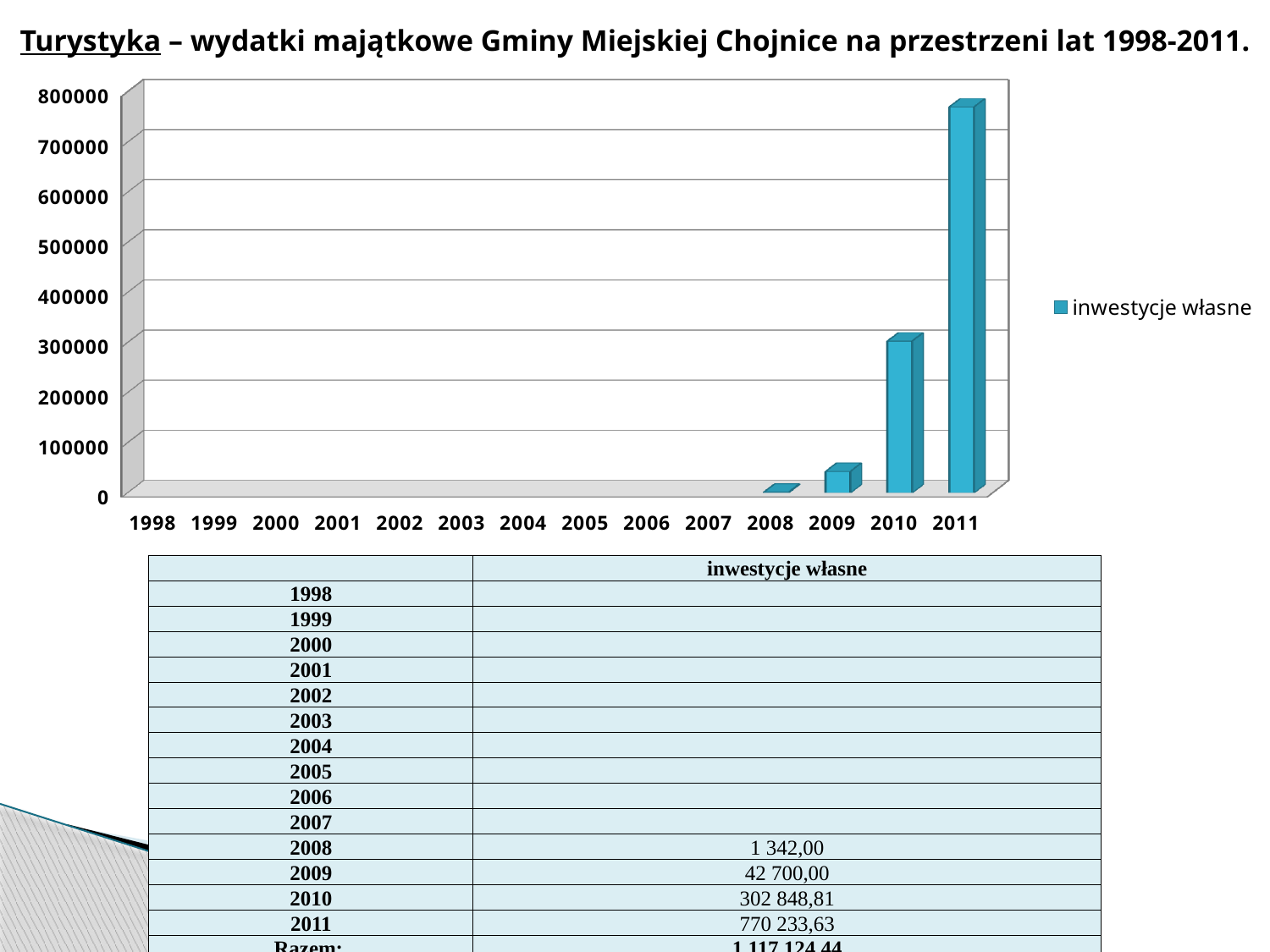
Is the value for 2010 greater or less than 400000? less Do the values rise or fall from 2008 to 2011? rise How many years are shown on the x axis of the chart? 14 Which is larger, the value for 2009 or the value for 2010? 2010 How many series does the chart legend list? 1 Which year has the highest value for inwestycje własne? 2011 What is the value of inwestycje własne for 2008? 1 342,00 What is the name of the series shown in the chart legend? inwestycje własne What is the value of inwestycje własne for 2011? 770 233,63 What is the value of inwestycje własne for 2010? 302 848,81 What type of chart is shown on the slide? bar chart What is the value of inwestycje własne for 2009? 42 700,00